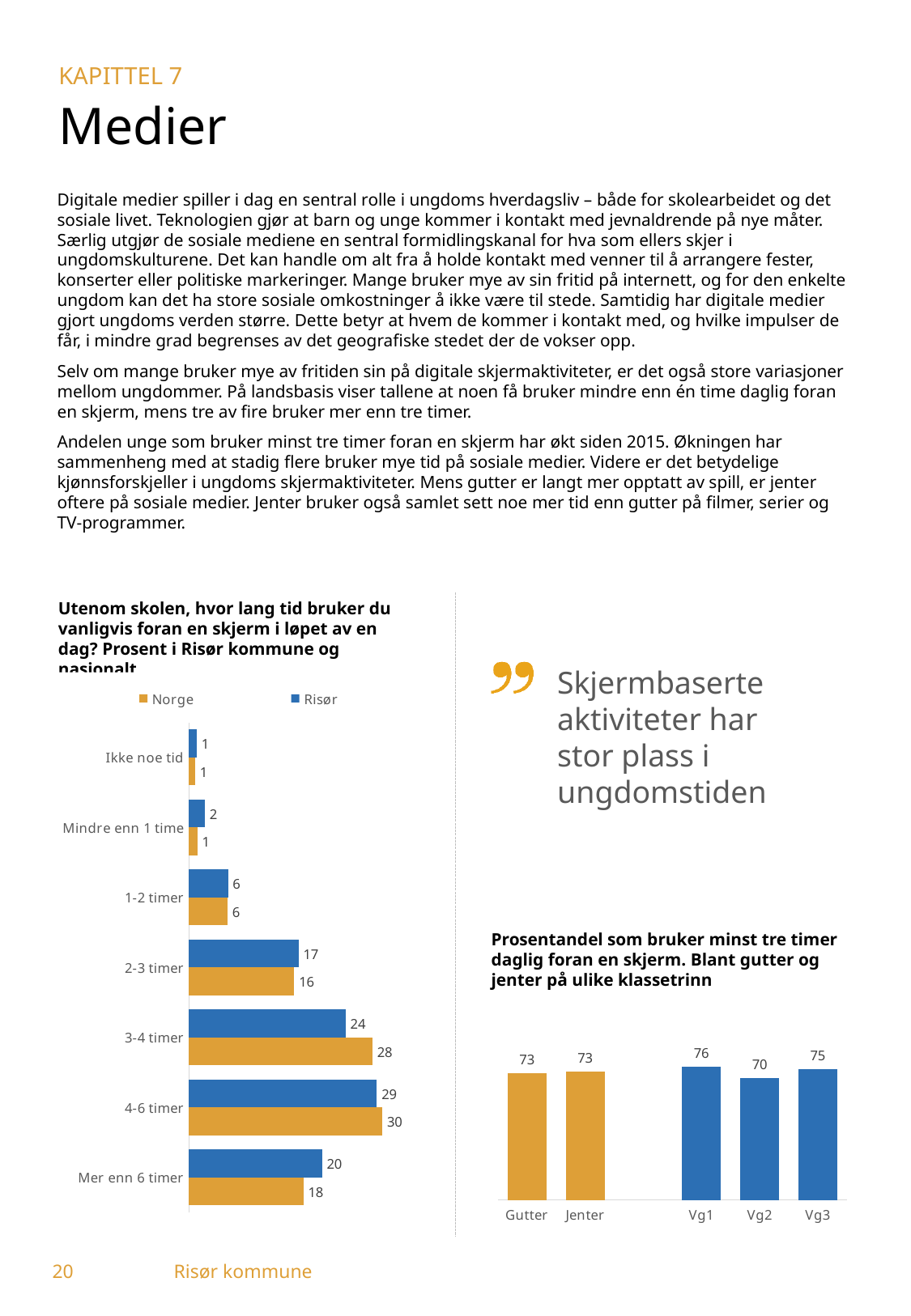
In the left chart (Utenom skolen, hvor lang tid bruker du vanligvis foran en skjerm), what is the Risør value for 4-6 timer? 29 In the right chart (Prosentandel som bruker minst tre timer daglig foran en skjerm), what is the value for Vg2? 70 In the left chart (Utenom skolen, hvor lang tid bruker du vanligvis foran en skjerm), what is the Norge value for 3-4 timer? 28 In the left chart (Utenom skolen, hvor lang tid bruker du vanligvis foran en skjerm), which category has the highest Risør value? 4-6 timer In the left chart (Utenom skolen, hvor lang tid bruker du vanligvis foran en skjerm), how many series does the legend list? 2 In the right chart (Prosentandel som bruker minst tre timer daglig foran en skjerm), which category has the highest value? Vg1 In the left chart (Utenom skolen, hvor lang tid bruker du vanligvis foran en skjerm), what is the difference between the Norge and Risør values for 3-4 timer? 4 In the left chart (Utenom skolen, hvor lang tid bruker du vanligvis foran en skjerm), how many categories are shown? 7 In the right chart (Prosentandel som bruker minst tre timer daglig foran en skjerm), what is the difference between Vg1 and Vg2? 6 In the left chart (Utenom skolen, hvor lang tid bruker du vanligvis foran en skjerm), which is larger for Mer enn 6 timer: Norge or Risør? Risør What kind of chart is the left chart (Utenom skolen, hvor lang tid bruker du vanligvis foran en skjerm)? Bar chart In the right chart (Prosentandel som bruker minst tre timer daglig foran en skjerm), how many bars are shown? 5